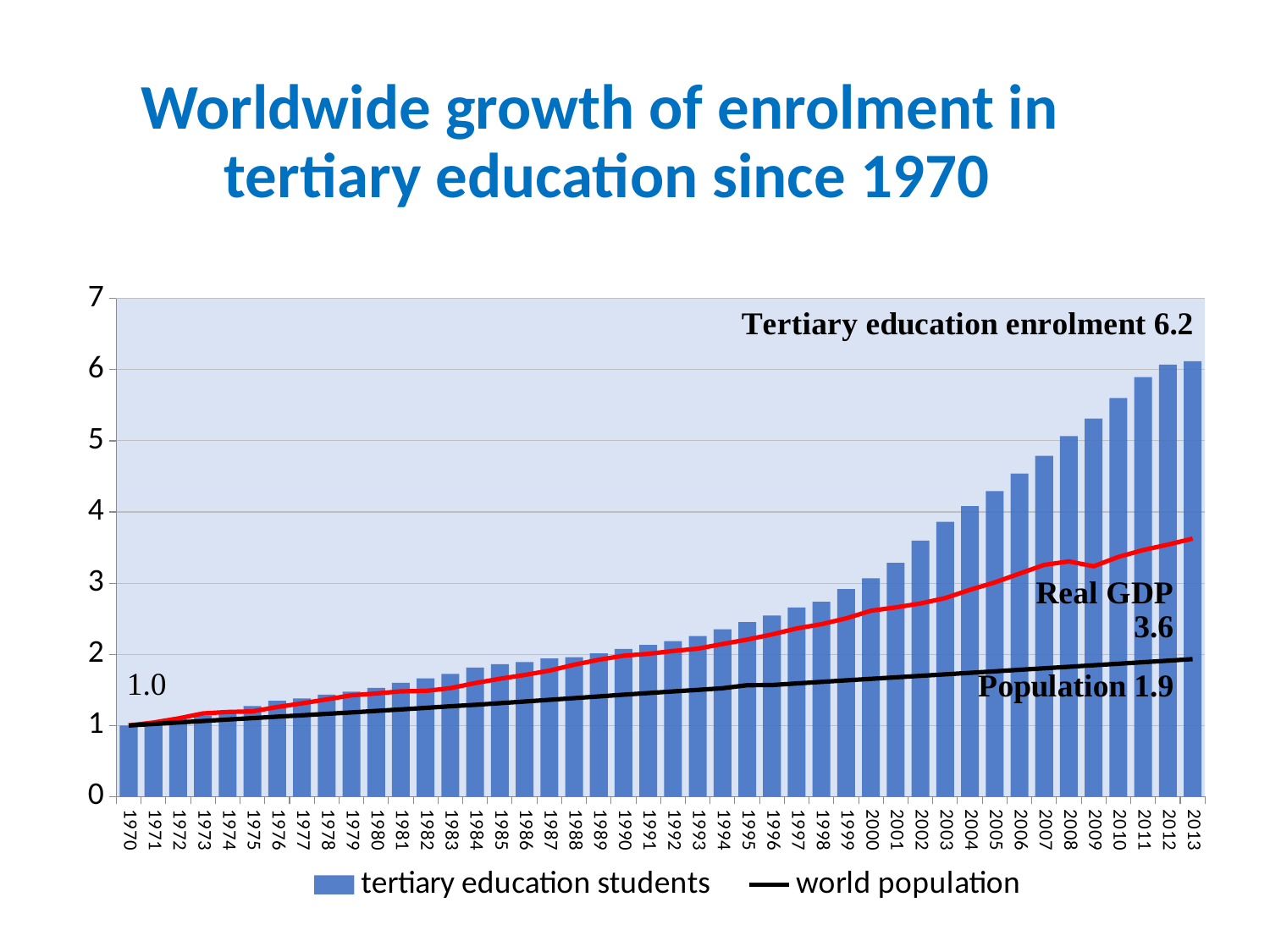
What is the title of the slide containing the chart? Worldwide growth of enrolment in tertiary education since 1970 How many series does the legend list? 2 What is the Real GDP value labelled at the end of the red line? 3.6 Which is larger in 2013: tertiary education enrolment or Real GDP? Tertiary education enrolment What is the tertiary education enrolment value shown for 2013? 6.2 What value is labelled at the start of the series in 1970? 1.0 Is the tertiary education students bar for 2010 greater or less than 5? greater Do the tertiary education students bars rise or fall from 1970 to 2013? Rise What is the difference between the tertiary education enrolment value (6.2) and the Population value (1.9) in 2013? 4.3 What is the difference between the tertiary education enrolment value (6.2) and the Real GDP value (3.6)? 2.6 Is the tertiary education students bar for 1980 greater or less than 2? less What is the Population value labelled at the end of the black line? 1.9